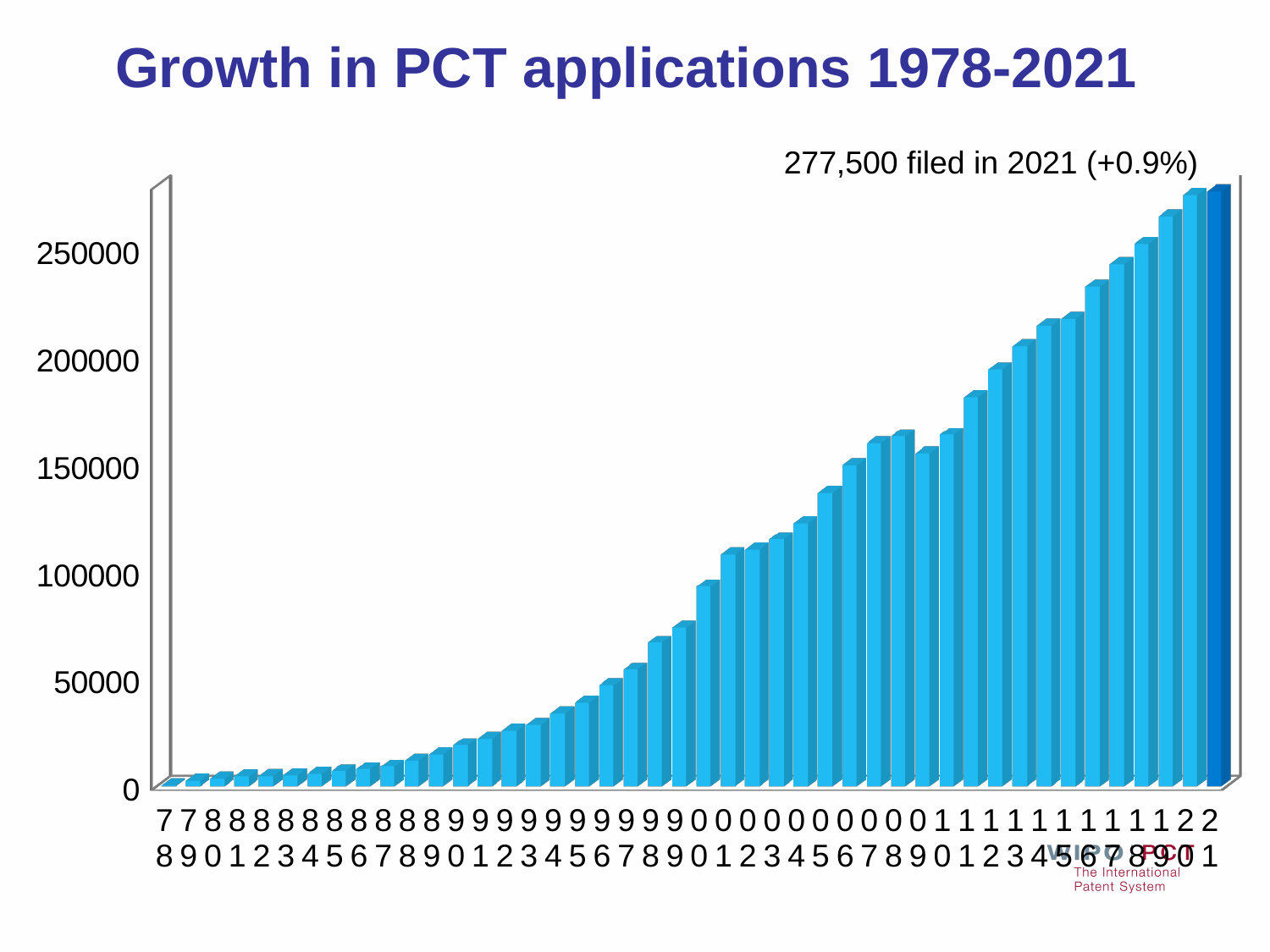
Which year has the lowest number of PCT applications? 1978 Which year has the highest number of PCT applications? 2021 Is the value for 1990 greater or less than 50000? less How many PCT applications were filed in 2021 according to the slide? 277,500 What kind of chart is shown on the slide? bar chart Is the value for 2000 greater or less than 100000? less What percentage change in PCT applications for 2021 is noted on the slide? +0.9% Is the value for 2015 greater or less than 200000? greater Which year had more PCT applications, 2008 or 2009? 2008 How many years (bars) are plotted in the chart? 44 Do the values generally rise or fall from 1978 to 2021? rise